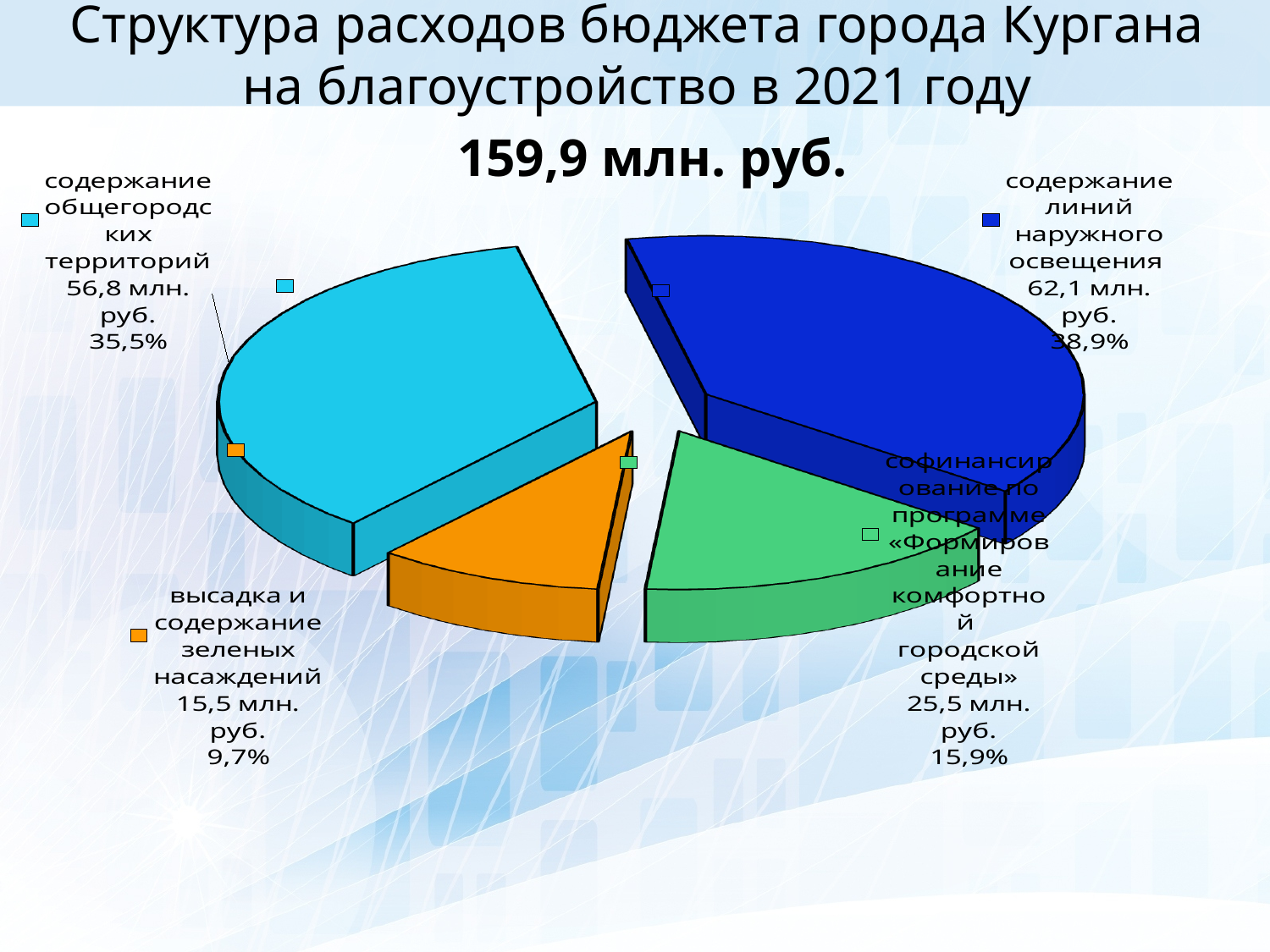
На сколько млн. руб. расходы на «содержание линий наружного освещения» больше расходов на «содержание общегородских территорий»? 5,3 млн. руб. Какой тип диаграммы показан на слайде? круговая диаграмма Каким цветом на диаграмме показан сектор «высадка и содержание зеленых насаждений»? оранжевым Какая доля расходов приходится на «содержание общегородских территорий»? 35,5% Какая сумма расходов указана для категории «высадка и содержание зеленых насаждений»? 15,5 млн. руб. Какая доля расходов приходится на «софинансирование по программе «Формирование комфортной городской среды»»? 15,9% Какая категория имеет наибольшую долю расходов? содержание линий наружного освещения Какая категория имеет наименьшую долю расходов? высадка и содержание зеленых насаждений Что больше: расходы на «софинансирование по программе «Формирование комфортной городской среды»» или на «высадку и содержание зеленых насаждений»? софинансирование по программе «Формирование комфортной городской среды» Сколько категорий (секторов) показано на диаграмме? 4 Какая сумма расходов указана для категории «содержание линий наружного освещения»? 62,1 млн. руб. Какая общая сумма расходов бюджета на благоустройство указана на слайде? 159,9 млн. руб.